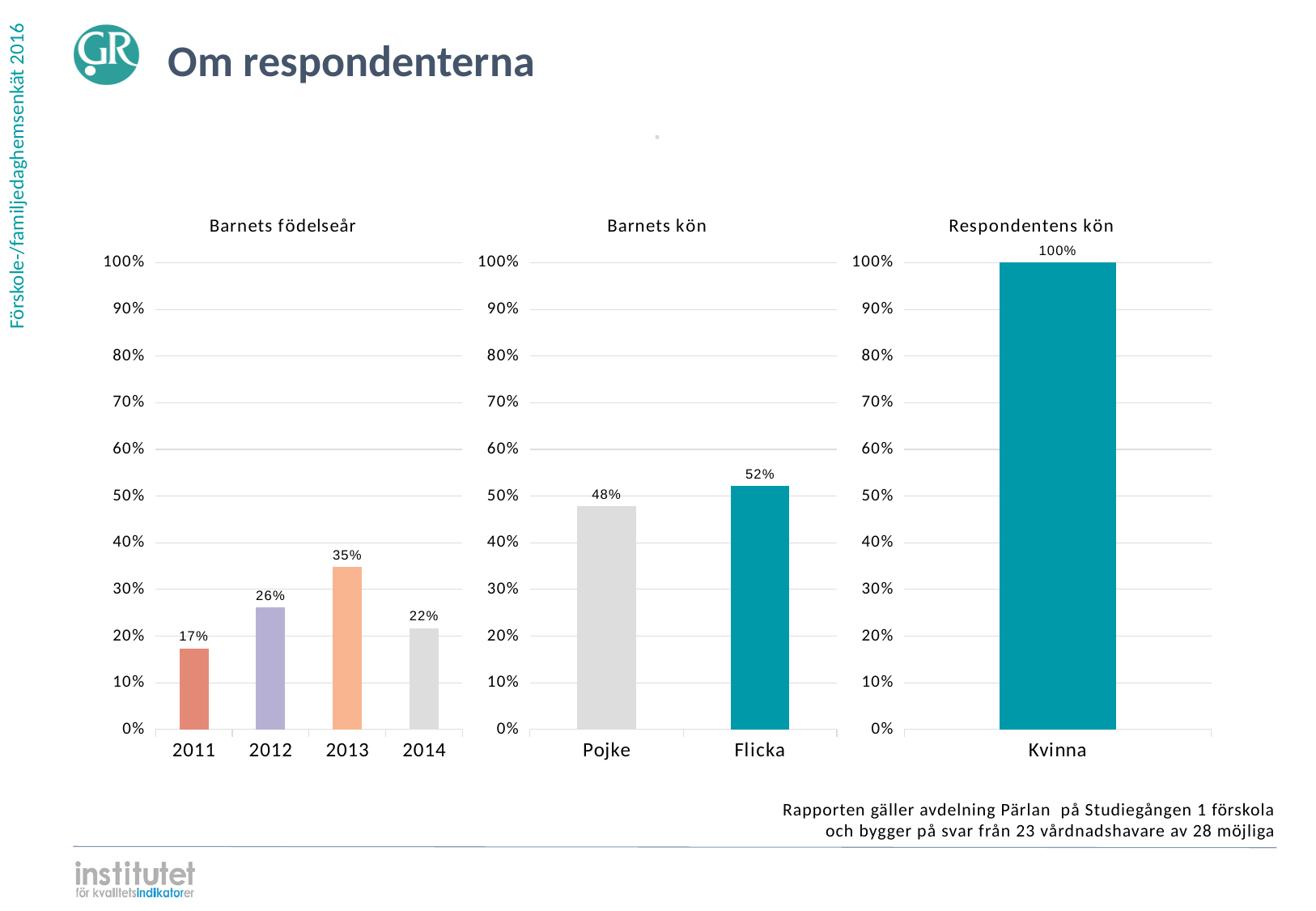
In the 'Respondentens kön' chart, what is the value for Kvinna? 100% In the 'Barnets födelseår' chart, how many birth years are shown on the x axis? 4 In the 'Barnets födelseår' chart, what is the difference between the values for 2012 and 2014? 4% In the 'Respondentens kön' chart, how many categories are shown on the x axis? 1 In the 'Barnets födelseår' chart, which birth year has the highest value? 2013 What kind of chart is the 'Barnets kön' chart? Bar chart In the 'Barnets födelseår' chart, what is the value for 2013? 35% In the 'Barnets kön' chart, what is the difference between Flicka and Pojke? 4% How many charts are shown on the slide? 3 In the 'Barnets kön' chart, what is the value for Pojke? 48% In the 'Barnets födelseår' chart, which birth year has the lowest value? 2011 In the 'Barnets kön' chart, which is larger, Pojke or Flicka? Flicka